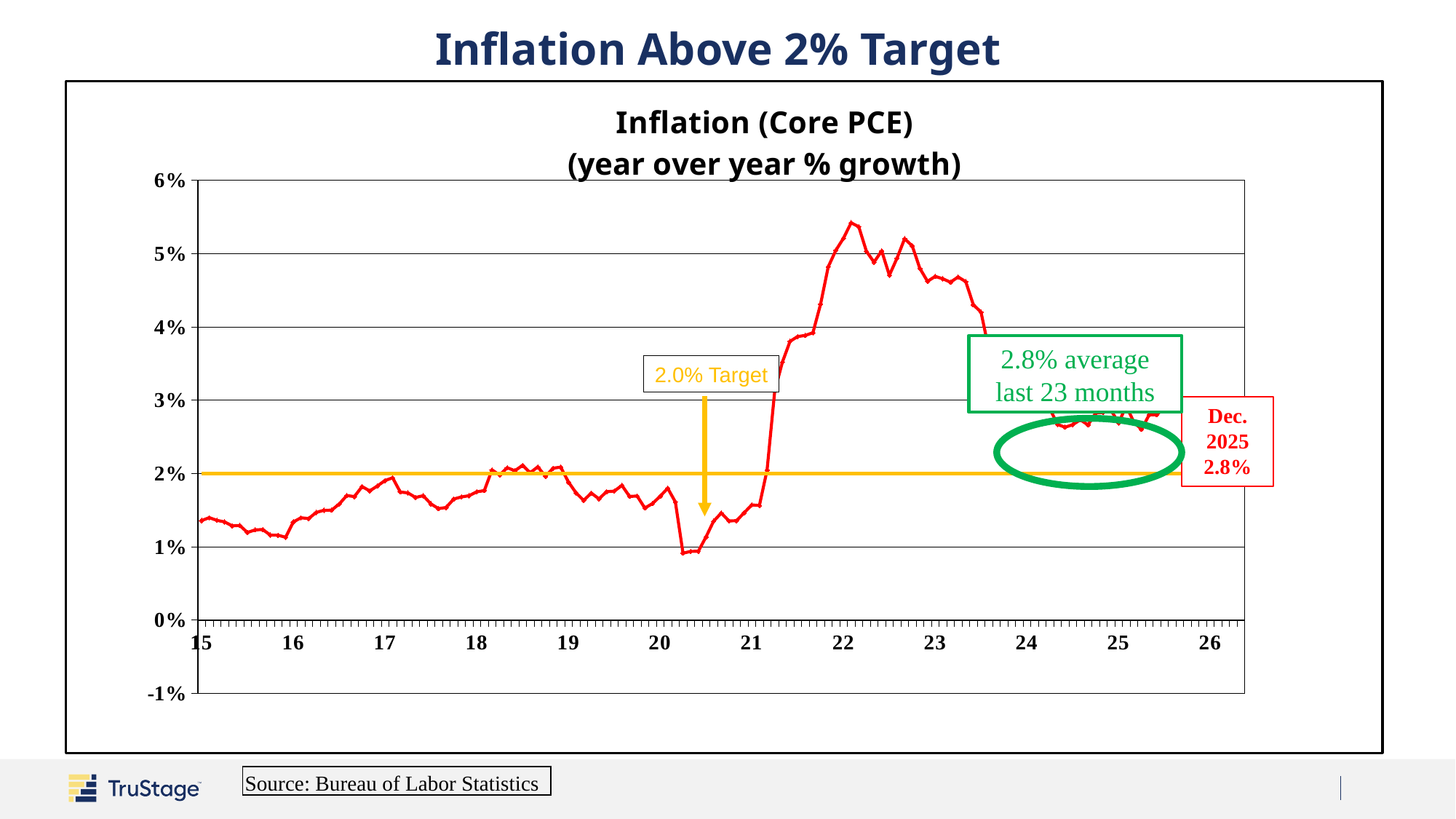
Around which year does the Core PCE inflation line reach its lowest value? 2020 In which year does the Core PCE inflation line reach its highest value? 2022 Between 2022 and 2024, does the Core PCE inflation line rise or fall? fall Is the lowest point of the line, around 2020, greater or less than 2%? less What inflation target level is marked by the horizontal line on the chart? 2.0% Is the Core PCE inflation value at the start of 2015 greater or less than 2%? less What is the Core PCE inflation value labelled for Dec. 2025? 2.8% Is the peak value of the Core PCE inflation line greater or less than 5%? greater What is the title of the chart? Inflation (Core PCE) (year over year % growth) What source is cited for the chart data? Bureau of Labor Statistics What kind of chart is shown on the slide? line chart What average value over the last 23 months is annotated on the chart? 2.8%